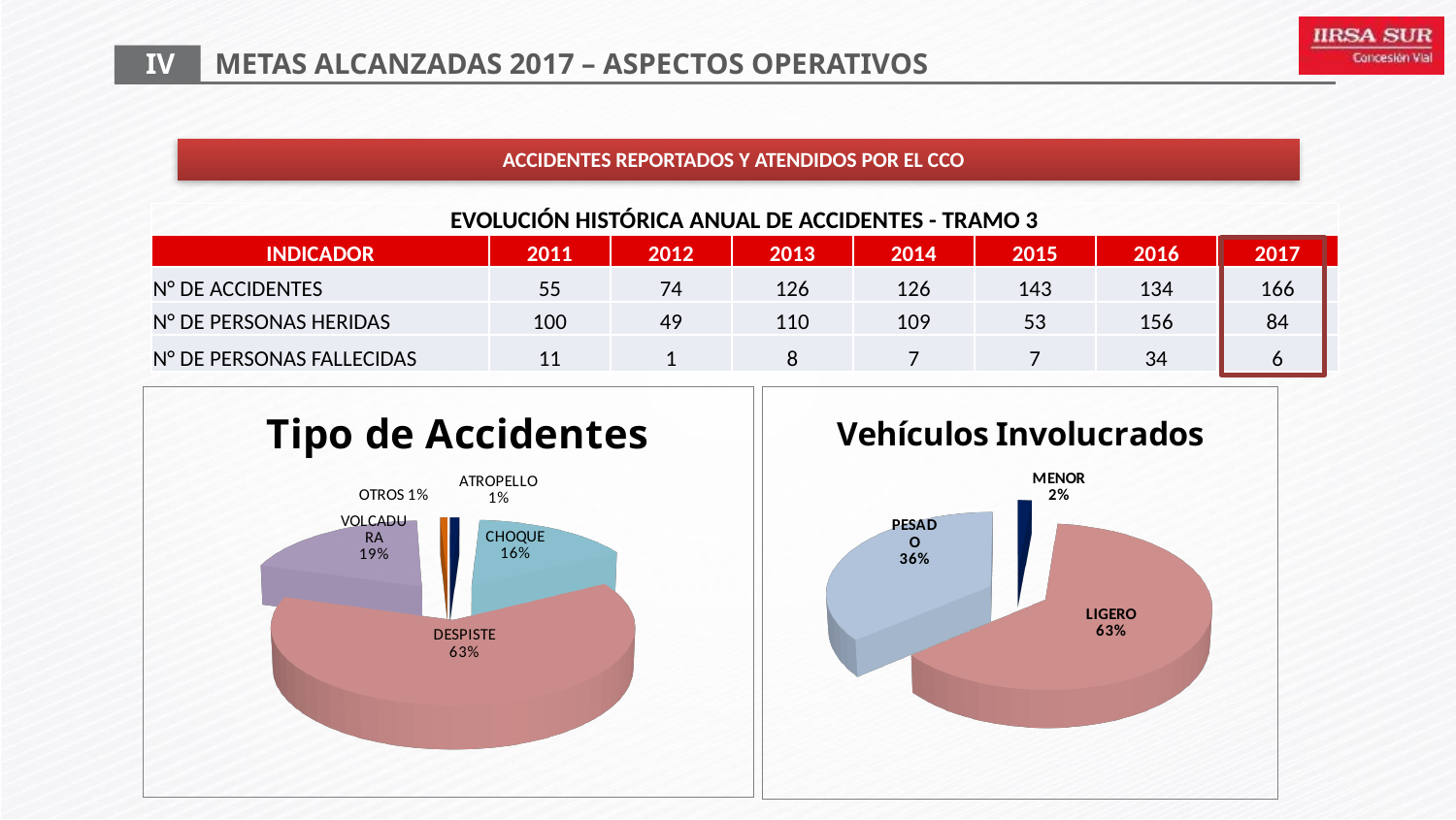
In the 'Vehículos Involucrados' chart, what percentage is shown for PESADO? 36% In the 'Vehículos Involucrados' chart, which is larger, PESADO or MENOR? PESADO What kind of chart is 'Vehículos Involucrados'? Pie chart In the 'Tipo de Accidentes' chart, what percentage is shown for VOLCADURA? 19% In the 'Vehículos Involucrados' chart, which vehicle category has the smallest share? MENOR In the 'Vehículos Involucrados' chart, how many categories are shown? 3 In the 'Tipo de Accidentes' chart, which type of accident has the largest share? DESPISTE In the 'Tipo de Accidentes' chart, how many slices does the pie have? 5 In the 'Tipo de Accidentes' chart, what share of accidents is DESPISTE? 63% In the 'Vehículos Involucrados' chart, what share is LIGERO? 63% In the 'Tipo de Accidentes' chart, what percentage is shown for CHOQUE? 16% In the 'Tipo de Accidentes' chart, what is the difference in percentage points between VOLCADURA and CHOQUE? 3